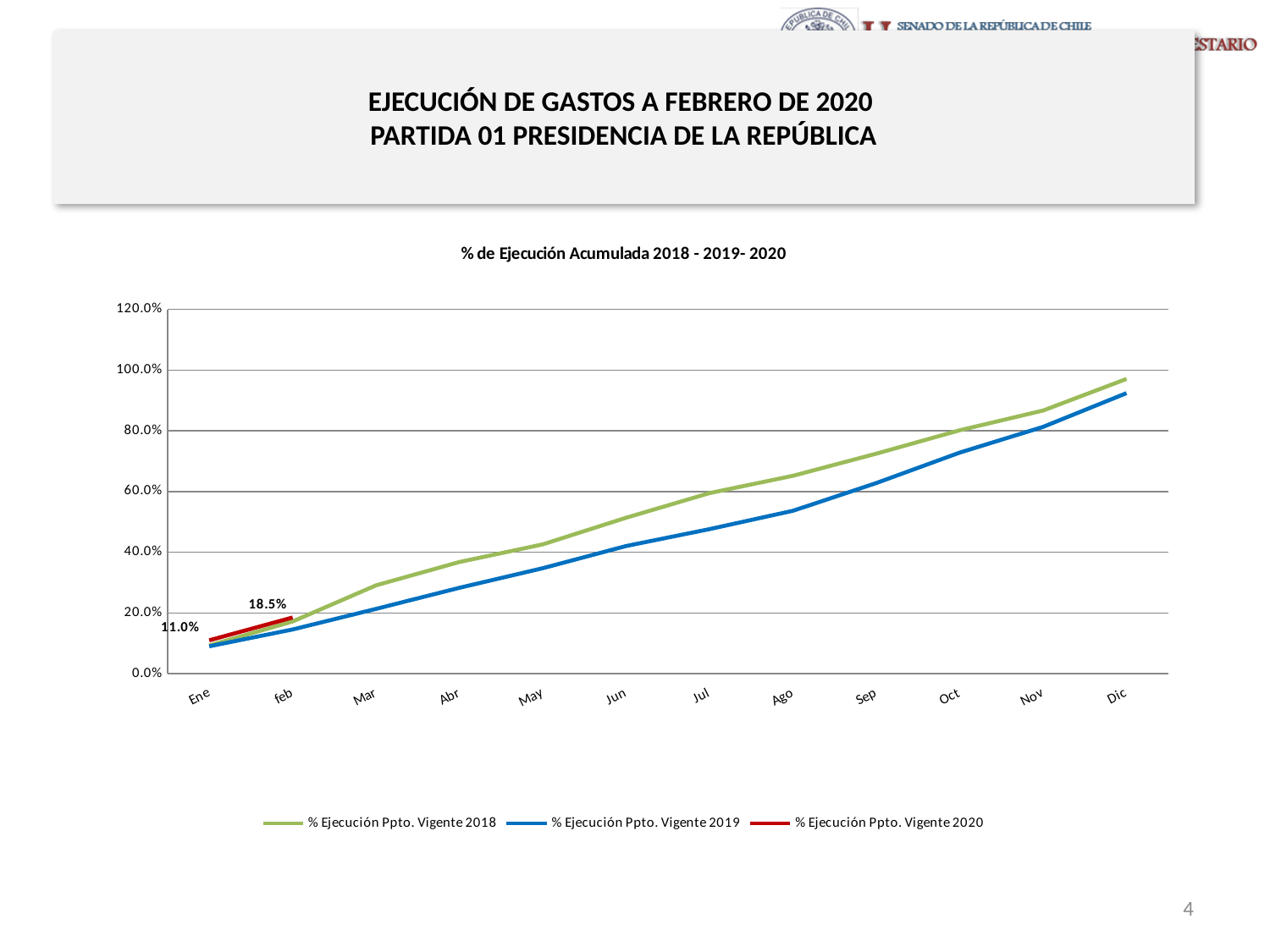
What colour is the line for % Ejecución Ppto. Vigente 2020? red Do the values of % Ejecución Ppto. Vigente 2019 rise or fall from Ene to Dic? rise How many months are shown on the x axis? 12 What type of chart is shown on the slide? line chart Which series has the higher value in Dic, % Ejecución Ppto. Vigente 2018 or % Ejecución Ppto. Vigente 2019? % Ejecución Ppto. Vigente 2018 Is the value of % Ejecución Ppto. Vigente 2018 for Dic greater or less than 80.0%? greater How many series does the legend list? 3 What is the value of % Ejecución Ppto. Vigente 2020 for Ene? 11.0% What is the difference between the Feb and Ene values of % Ejecución Ppto. Vigente 2020? 7.5% What is the value of % Ejecución Ppto. Vigente 2020 for Feb? 18.5% Is the value of % Ejecución Ppto. Vigente 2019 for Ago greater or less than 40.0%? greater What is the title of the chart? % de Ejecución Acumulada 2018 - 2019- 2020